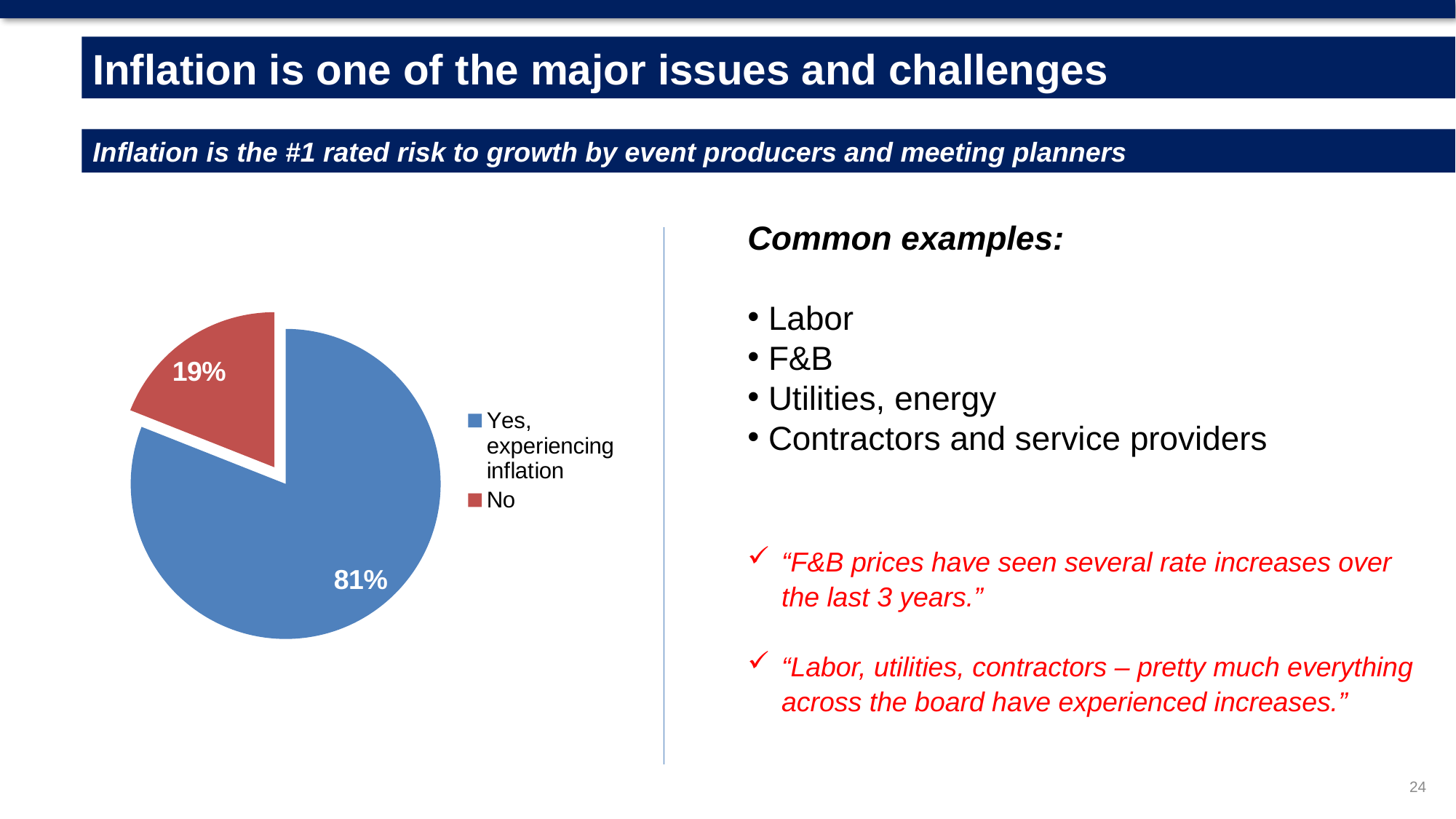
What kind of chart is shown on the slide? Pie chart What colour is the "No" slice in the pie chart? Red What percentage of the pie is labelled "No"? 19% How many slices does the pie chart have? 2 Which is larger, the "Yes, experiencing inflation" slice or the "No" slice? Yes, experiencing inflation What share of the pie does the "No" slice represent? 19% Which slice of the pie is the smallest? No Which slice of the pie is the largest? Yes, experiencing inflation What is the difference in percentage points between the "Yes, experiencing inflation" slice and the "No" slice? 62 What colour is the "Yes, experiencing inflation" slice in the pie chart? Blue How many entries does the legend of the pie chart list? 2 What percentage of the pie is labelled "Yes, experiencing inflation"? 81%